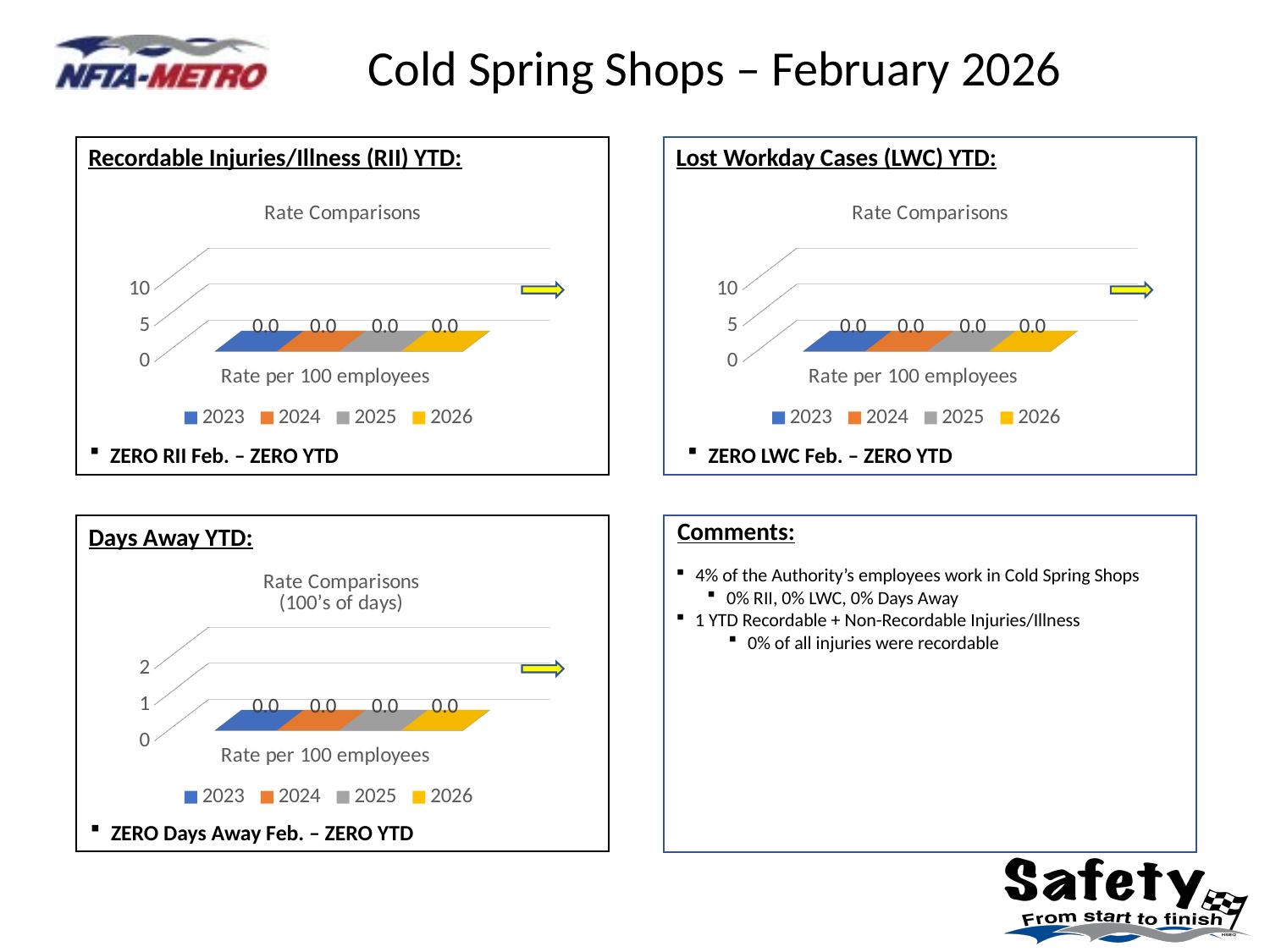
In the Days Away YTD chart, what is the value for 2025? 0.0 In the Recordable Injuries/Illness (RII) YTD chart, what is the value for 2026? 0.0 In the Lost Workday Cases (LWC) YTD chart, how many bars are plotted? 4 In the Lost Workday Cases (LWC) YTD chart, what kind of chart is shown? Bar chart In the Days Away YTD chart, what is the chart title? Rate Comparisons (100's of days) In the Recordable Injuries/Illness (RII) YTD chart, how many series does the legend list? 4 In the Days Away YTD chart, what is the value for 2024? 0.0 In the Recordable Injuries/Illness (RII) YTD chart, what is the label on the horizontal axis? Rate per 100 employees In the Days Away YTD chart, what is the highest value shown on the vertical axis? 2 In the Lost Workday Cases (LWC) YTD chart, is the value for 2025 greater or less than 5? less In the Lost Workday Cases (LWC) YTD chart, what is the value for 2023? 0.0 In the Recordable Injuries/Illness (RII) YTD chart, what is the difference between the 2024 and 2026 values? 0.0